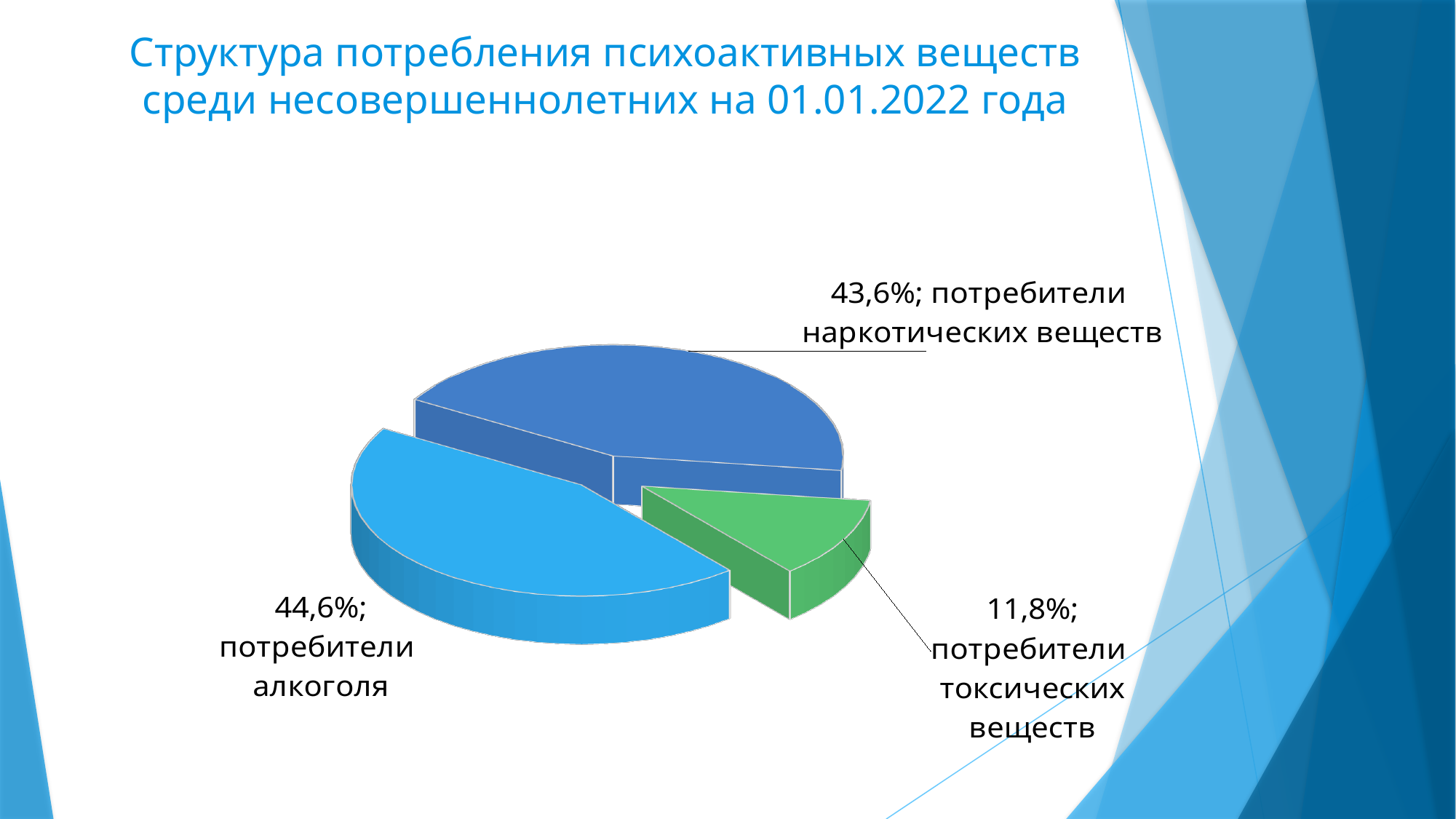
What share of the pie is labelled for потребители алкоголя? 44,6% Which category has the smallest share of the pie? потребители токсических веществ What share of the pie is labelled for потребители токсических веществ? 11,8% What kind of chart is shown on the slide? pie chart What is the difference between the shares for потребители алкоголя and потребители наркотических веществ? 1,0% What colour is the slice for потребители токсических веществ? green How many slices does the pie chart have? 3 What is the difference between the shares for потребители наркотических веществ and потребители токсических веществ? 31,8% Which is larger: the share for потребители наркотических веществ or the share for потребители токсических веществ? потребители наркотических веществ What share of the pie is labelled for потребители наркотических веществ? 43,6% Which category has the largest share of the pie? потребители алкоголя What is the title of the slide containing the chart? Структура потребления психоактивных веществ среди несовершеннолетних на 01.01.2022 года